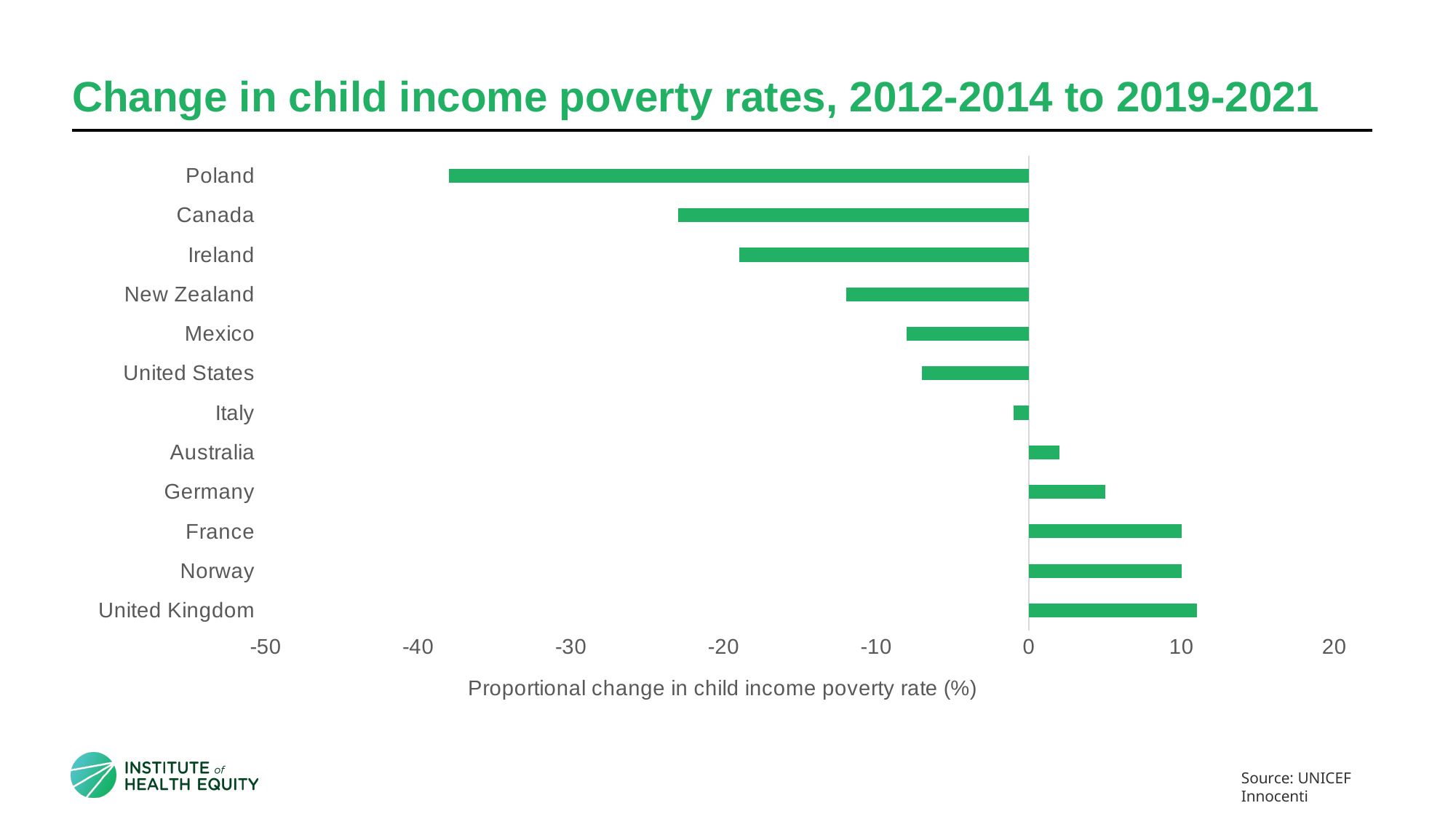
What is the title of the x axis? Proportional change in child income poverty rate (%) Is the value for New Zealand greater or less than -10? less Is the value for Canada greater or less than -20? less Is the value for Mexico greater or less than -10? greater Which country has the larger decrease in child income poverty rate, Canada or Ireland? Canada Which country has the larger increase in child income poverty rate, Australia or Germany? Germany What kind of chart is shown on the slide? Bar chart Which country shows the largest decrease in child income poverty rate? Poland How many countries are shown in the chart? 12